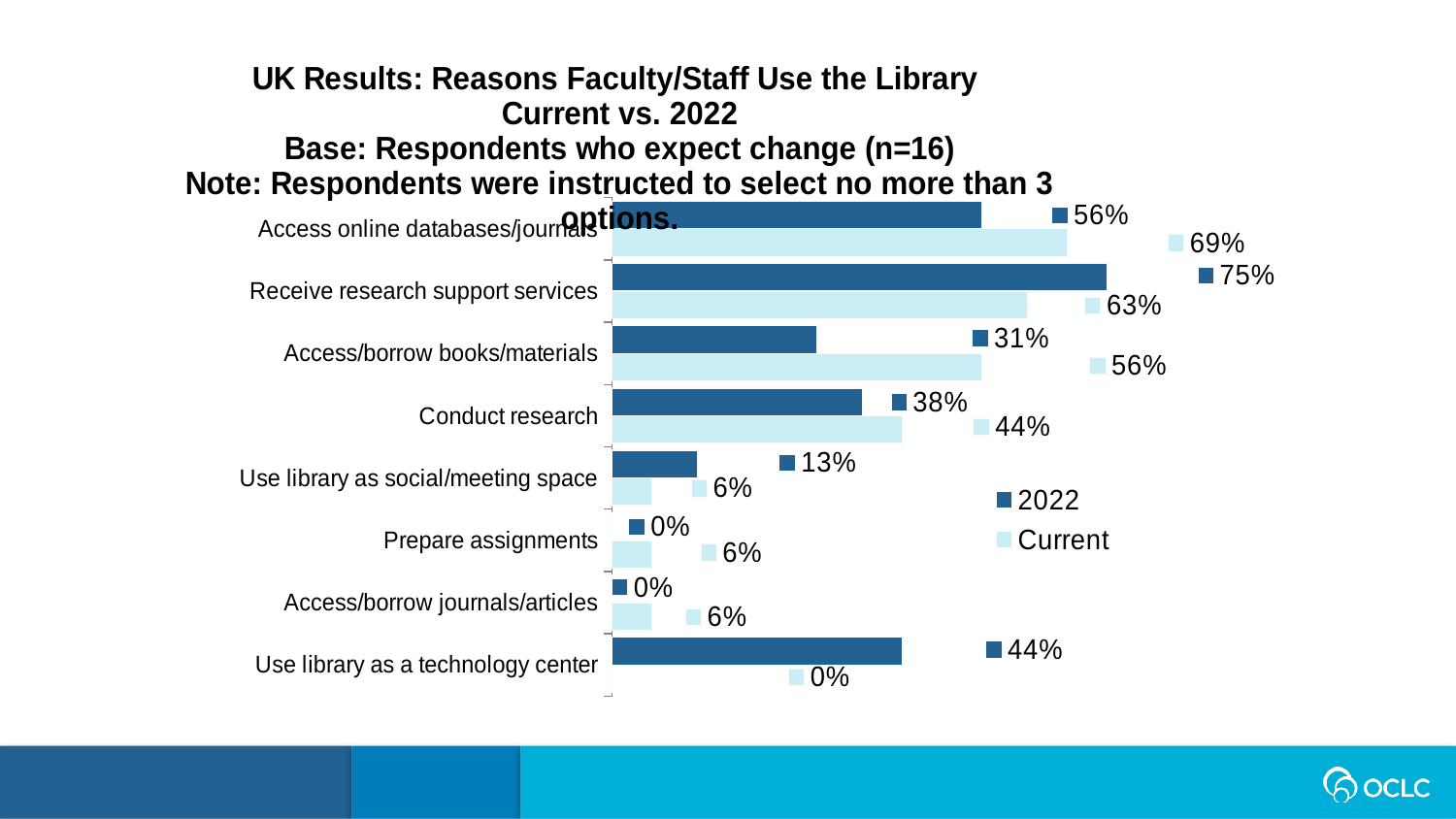
How many series does the legend list? 2 Which reason has the highest Current value? Access online databases/journals What is the 2022 value for Use library as social/meeting space? 13% Which series is shown in the darker blue colour? 2022 What is the Current value for Access online databases/journals? 69% For Conduct research, which is larger: the 2022 value or the Current value? Current What kind of chart is shown on the slide? bar chart What is the 2022 value for Receive research support services? 75% How many reasons (categories) are plotted on the chart? 8 Which reason has the highest 2022 value? Receive research support services What is the Current value for Use library as a technology center? 0% What is the difference between the Current and 2022 values for Access/borrow books/materials? 25%